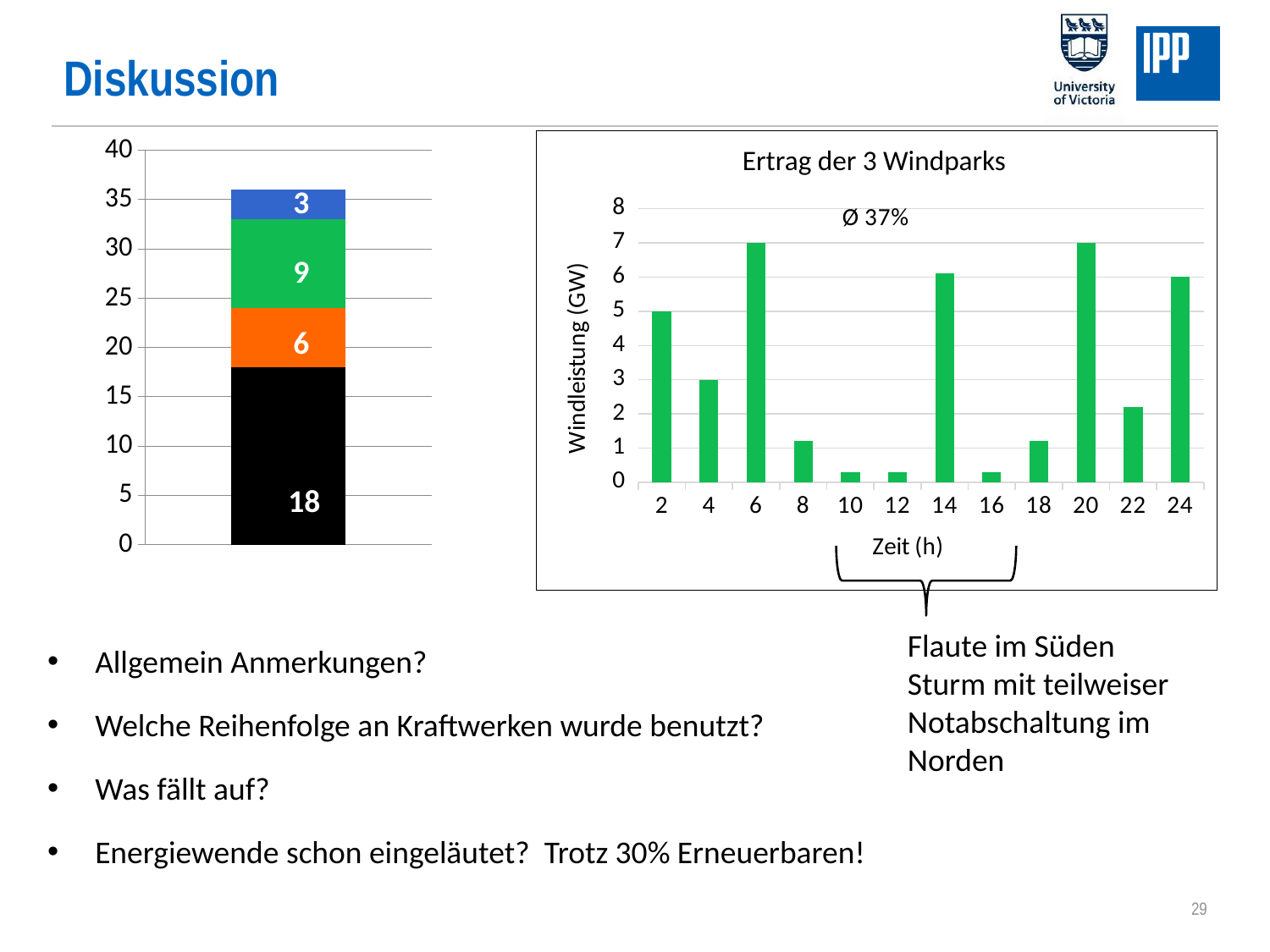
In the chart 'Ertrag der 3 Windparks', what is the wind power value at hour 2? 5 On the left stacked bar chart, what is the value of the green segment? 9 On the left stacked bar chart, what is the value of the black segment at the bottom of the bar? 18 On the left stacked bar chart, how many segments make up the bar? 4 In the chart 'Ertrag der 3 Windparks', which is larger, the value at hour 14 or the value at hour 8? Hour 14 In the chart 'Ertrag der 3 Windparks', what is the label of the y axis? Windleistung (GW) On the left stacked bar chart, which segment has the largest value? The black segment (18) On the left stacked bar chart, what is the total of all segments in the bar? 36 In the chart 'Ertrag der 3 Windparks', is the value at hour 10 greater or less than 1? less In the chart 'Ertrag der 3 Windparks', how many bars are plotted? 12 On the left stacked bar chart, what is the value of the orange segment? 6 On the left stacked bar chart, what is the difference between the green segment and the blue segment? 6